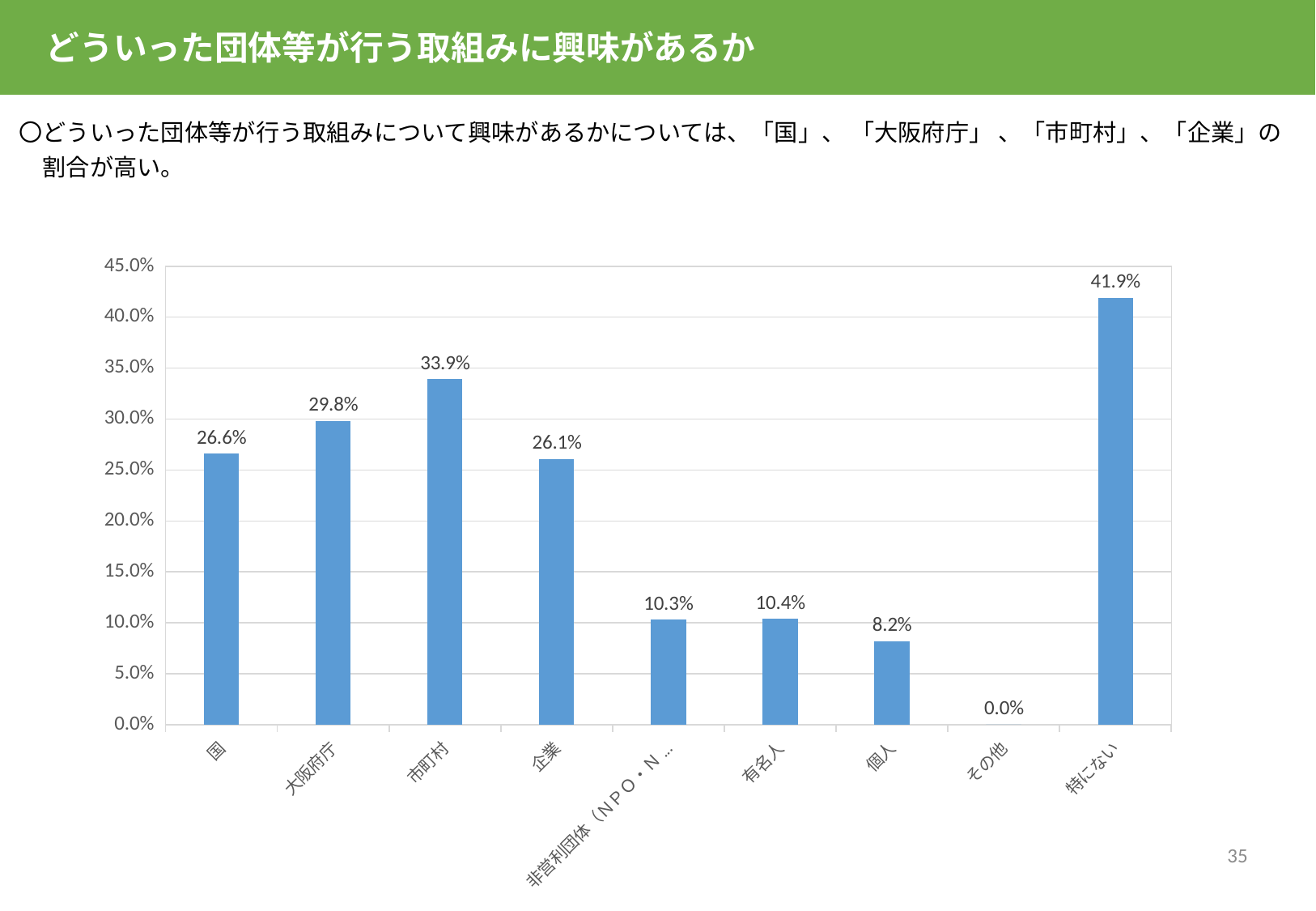
Which category has the highest value? 特にない What is the value for 個人? 8.2% What kind of chart is shown on the slide? bar chart What is the difference between the values for 市町村 and 大阪府庁? 4.1% Which category has the lowest value? その他 What is the value for 特にない? 41.9% What is the value for その他? 0.0% What is the value for 市町村? 33.9% What is the value for 国? 26.6% Is the value for 有名人 greater or less than 15.0%? less How many categories are shown on the x axis? 9 Which is larger, the value for 大阪府庁 or the value for 企業? 大阪府庁